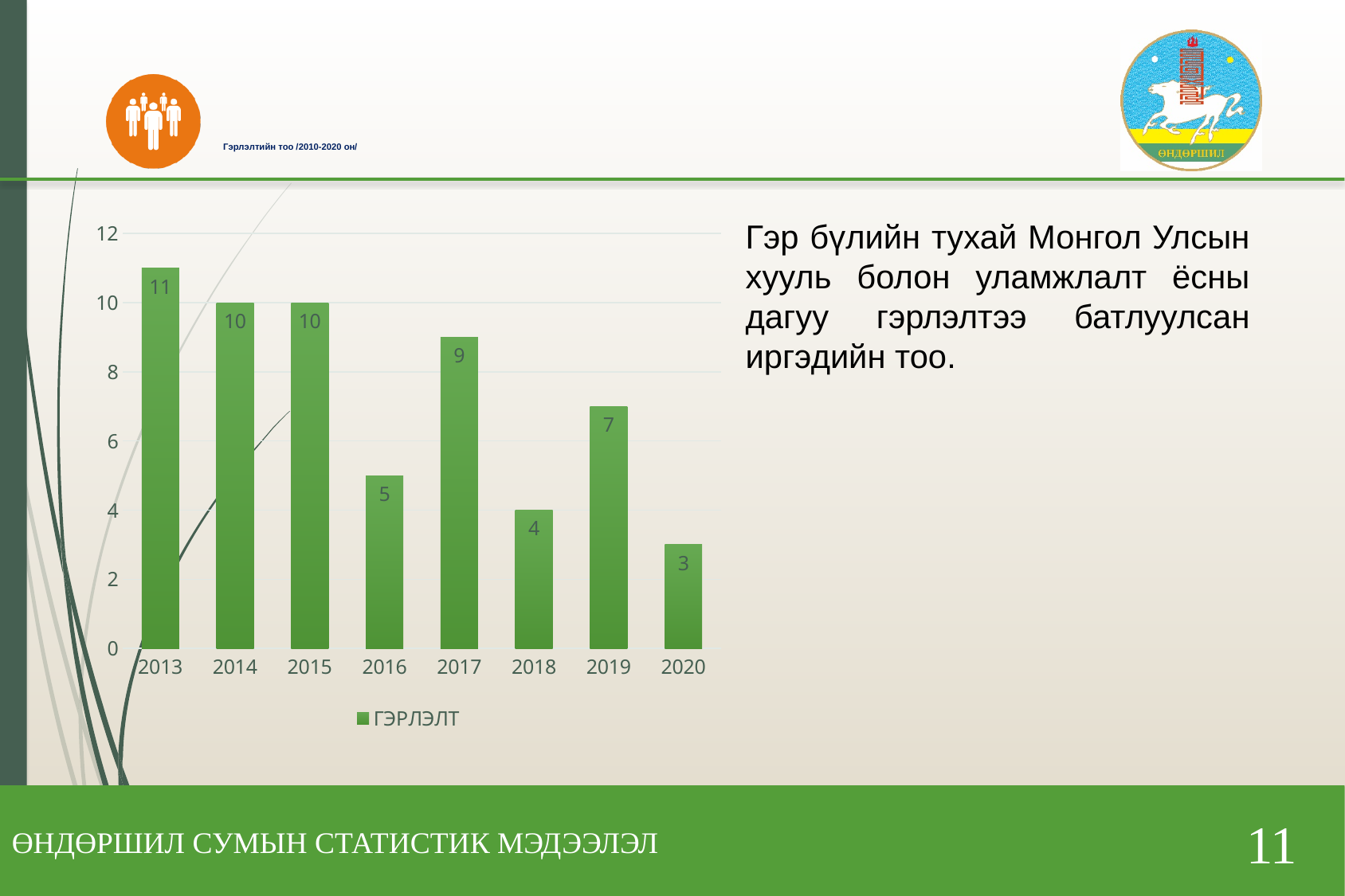
What is the value for 2016? 5 Which is larger, the value for 2017 or the value for 2019? 2017 How many series does the legend list? 1 What is the value for 2013? 11 What is the value for 2020? 3 How many years are shown on the x axis? 8 What kind of chart is shown? bar chart Which year has the lowest value? 2020 What is the difference between the values for 2013 and 2020? 8 Is the value for 2018 greater or less than 6? less Which year has the highest value? 2013 What is the name of the series in the legend? ГЭРЛЭЛТ